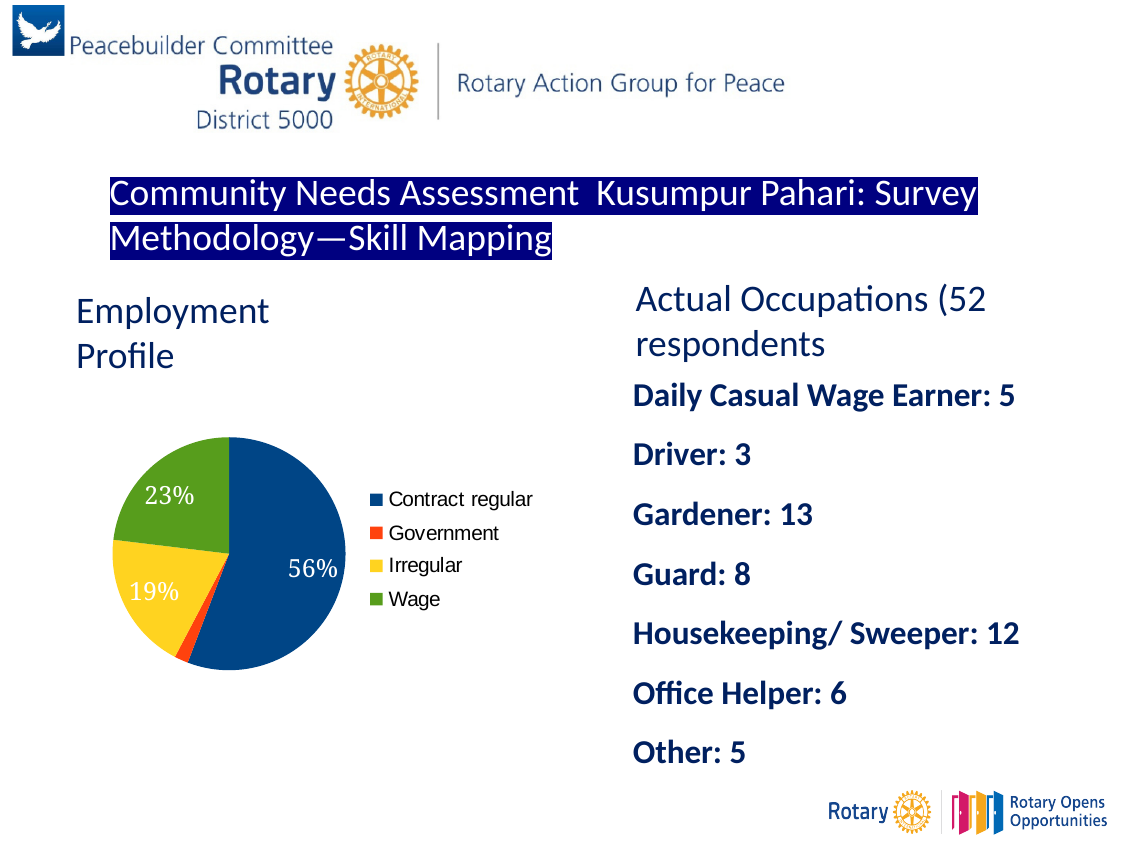
What kind of chart is shown under the heading "Employment Profile"? pie chart What percentage of the Employment Profile pie is Wage? 23% In the Employment Profile pie chart, how many percentage points larger is Wage than Irregular? 4 In the Employment Profile pie chart, how many percentage points larger is Contract regular than Wage? 33 What share of the Employment Profile pie does the Contract regular slice represent? 56% In the Employment Profile pie chart, which is larger, Wage or Irregular? Wage How many categories does the legend of the Employment Profile pie chart list? 4 What percentage of the Employment Profile pie is Contract regular? 56% What percentage of the Employment Profile pie is Irregular? 19% What colour represents Wage in the Employment Profile pie chart? green Which category has the largest slice in the Employment Profile pie chart? Contract regular Which category has the smallest slice in the Employment Profile pie chart? Government